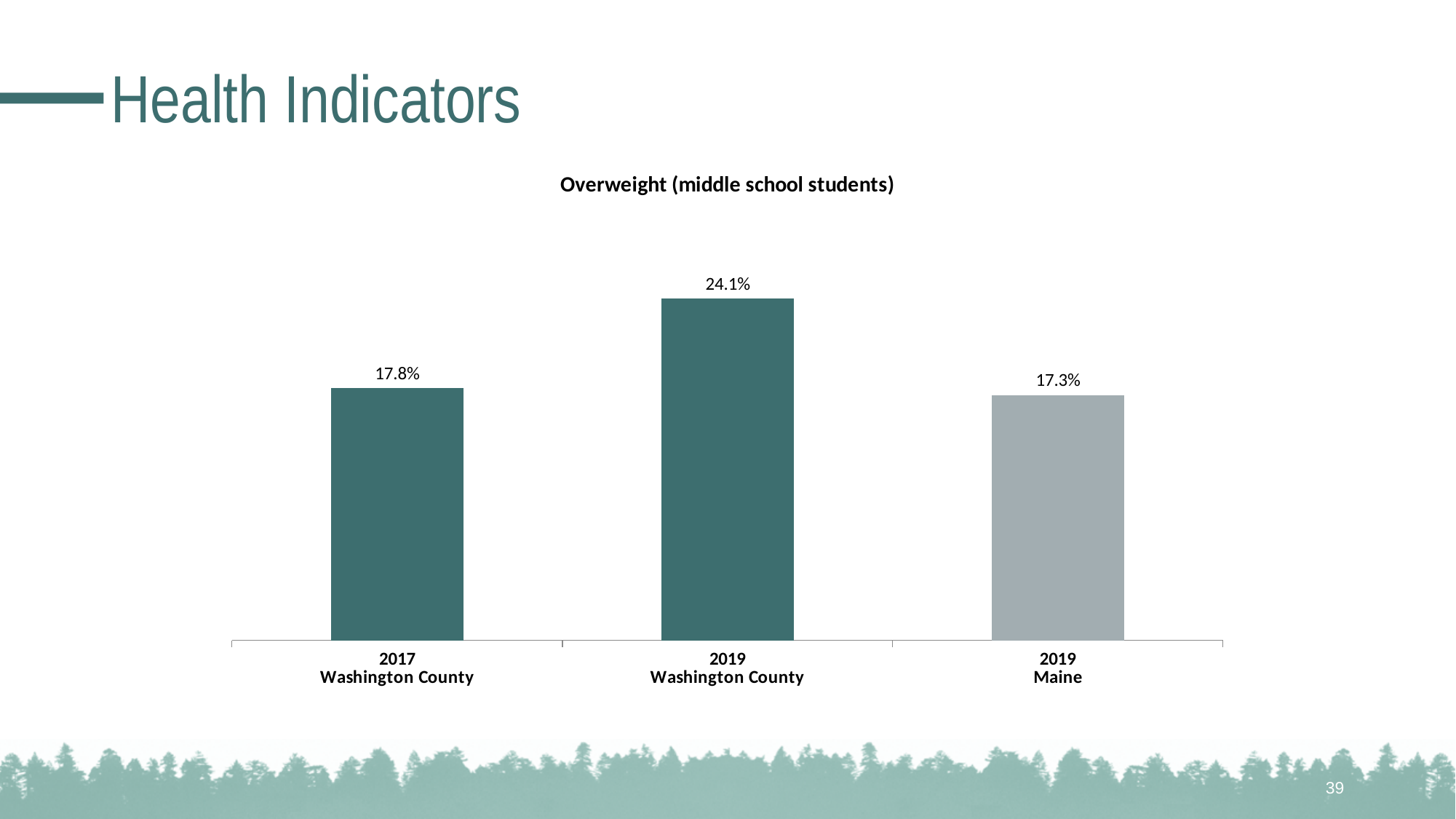
What is the difference between the 2019 Washington County value and the 2017 Washington County value? 6.3% What is the difference between the 2019 Washington County value and the 2019 Maine value? 6.8% Which is larger, the value for 2019 Washington County or the value for 2019 Maine? 2019 Washington County Did the Washington County value rise or fall from 2017 to 2019? Rise Which category has the lowest value? 2019 Maine What is the value for 2017 Washington County? 17.8% What kind of chart is shown on the slide? Bar chart What is the value for 2019 Washington County? 24.1% What is the title of the chart? Overweight (middle school students) Which category has the highest value? 2019 Washington County What is the value for 2019 Maine? 17.3% How many bars are shown in the chart? 3